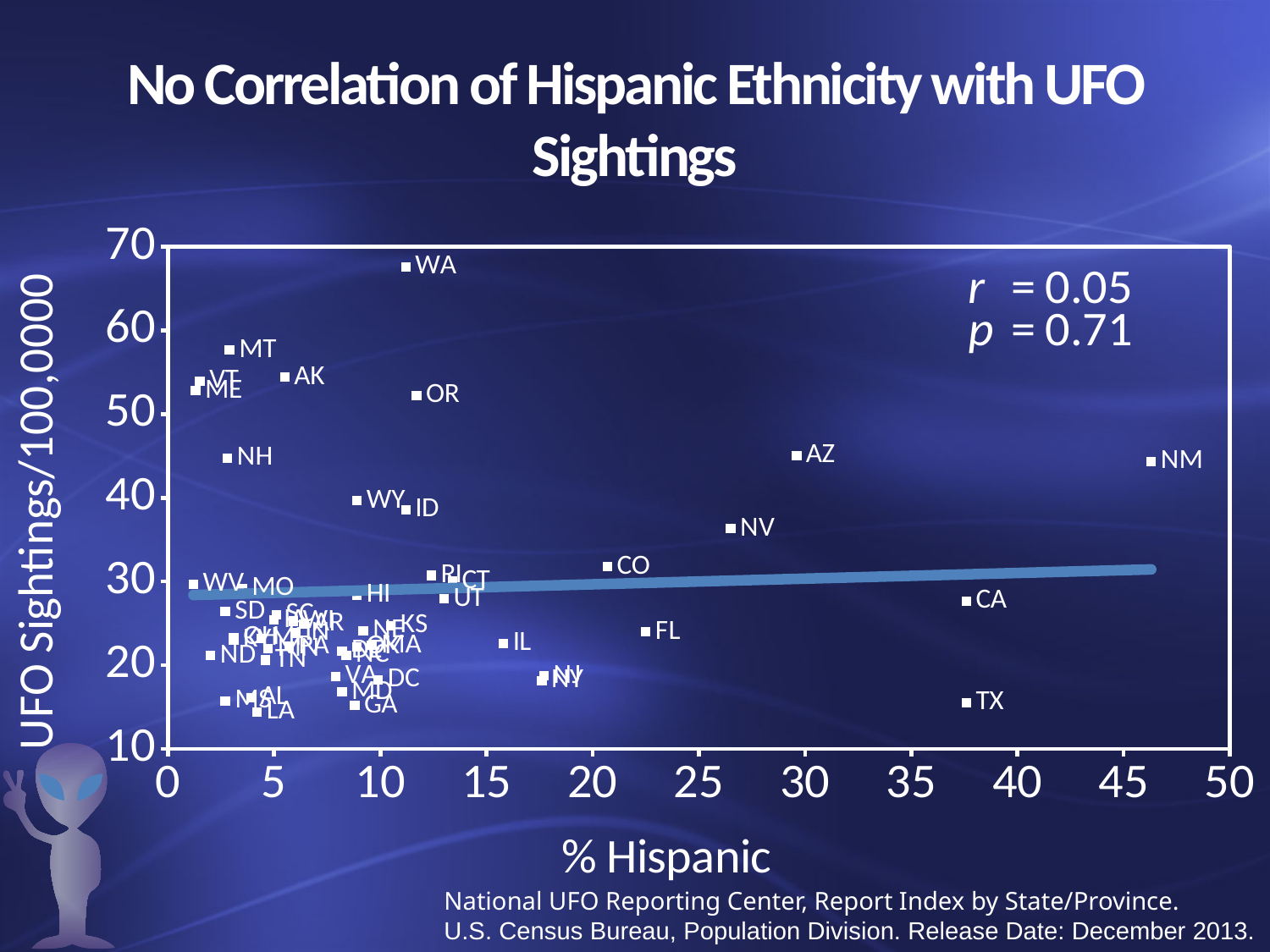
Is the UFO sightings value for WA greater or less than 60? greater Is the UFO sightings value for MT greater or less than 50? greater What kind of chart is shown on the slide? scatter plot What is the value of r shown on the chart? 0.05 What is the title of the chart? No Correlation of Hispanic Ethnicity with UFO Sightings Which state has a higher % Hispanic, NM or CA? NM Which state has the highest UFO sightings per 100,000 on the chart? WA Which state has more UFO sightings per 100,000, AZ or NV? AZ Is the % Hispanic value for NM greater or less than 40? greater Which state has the highest % Hispanic on the chart? NM